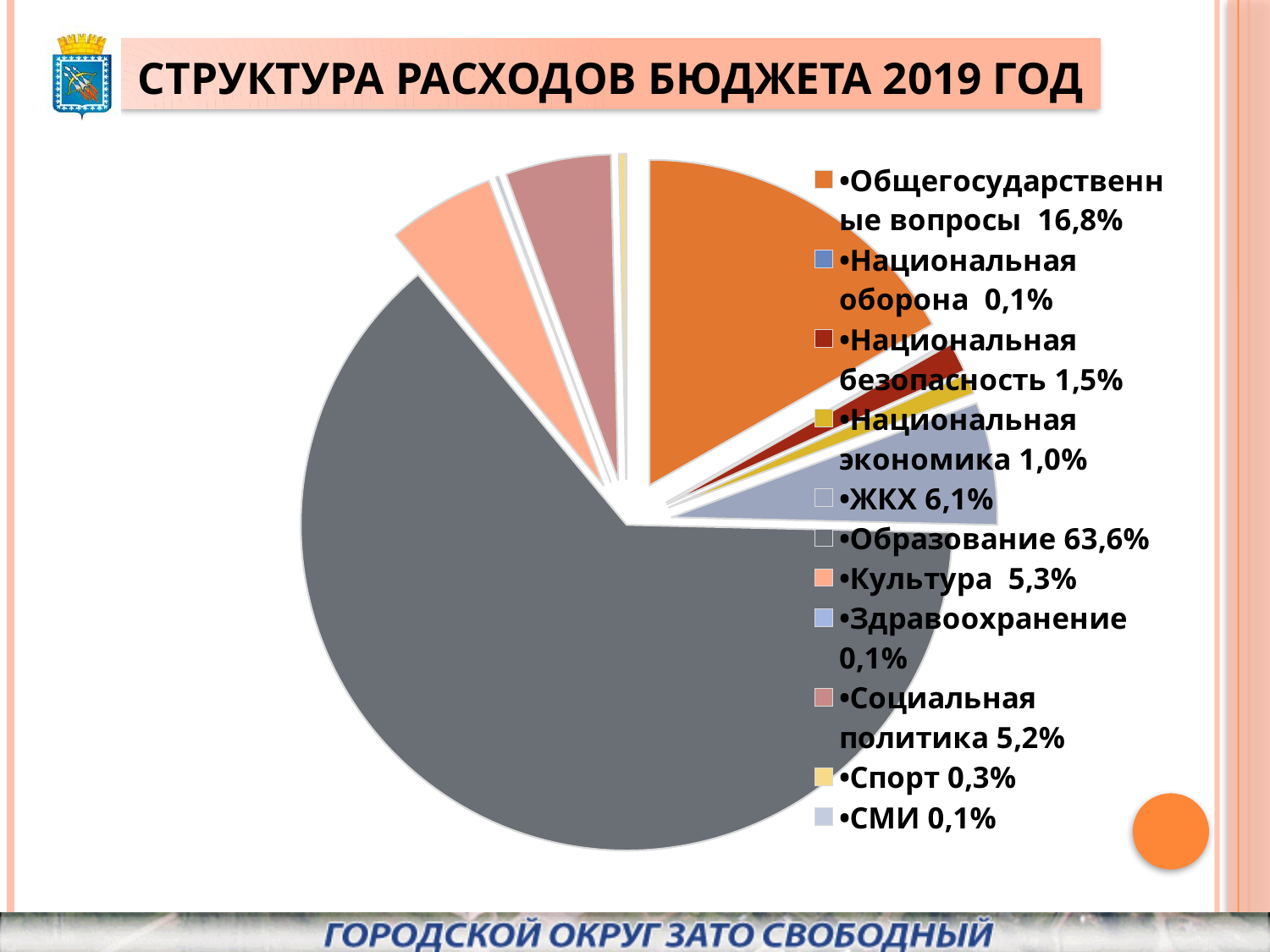
Which has a larger share, Национальная безопасность or Национальная экономика? Национальная безопасность What is the difference between the shares of Образование and Общегосударственные вопросы? 46,8% What is the value shown for Общегосударственные вопросы? 16,8% What percentage is shown for ЖКХ? 6,1% Which has a larger share, ЖКХ or Культура? ЖКХ What is the share for Социальная политика? 5,2% What share of the budget expenditure goes to Образование? 63,6% What type of chart is shown on the slide? Pie chart What percentage is listed for Спорт? 0,3% Which category has the largest share of the pie? Образование What is the title of the slide? СТРУКТУРА РАСХОДОВ БЮДЖЕТА 2019 ГОД How many categories are listed in the legend of the chart? 11